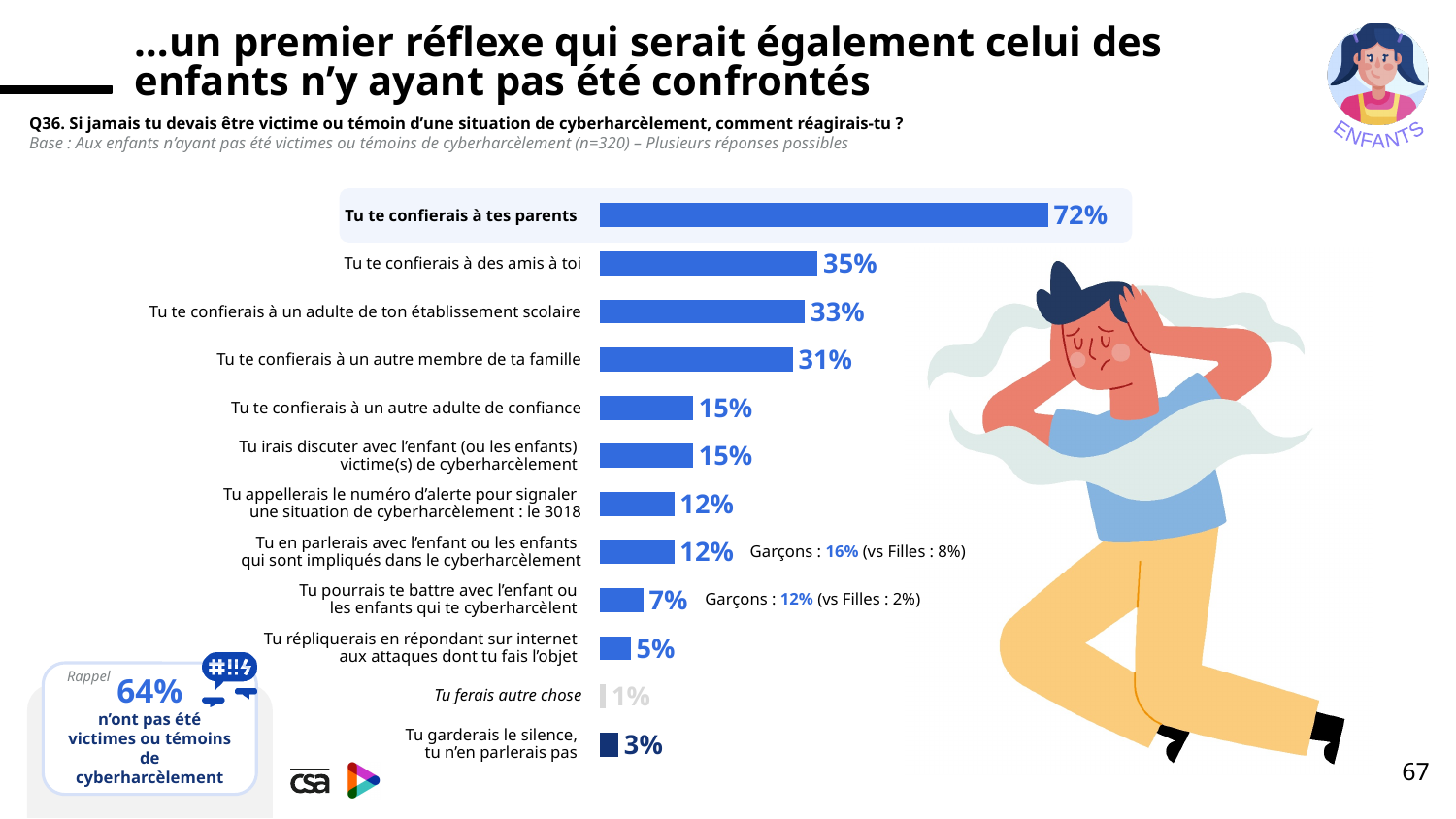
What is the difference in percentage points between "Tu te confierais à tes parents" and "Tu te confierais à des amis à toi"? 37 percentage points What percentage of children say they would confide in their parents ("Tu te confierais à tes parents")? 72% Which response has the lowest percentage? Tu ferais autre chose Which response has the highest percentage? Tu te confierais à tes parents What is the value for "Tu garderais le silence, tu n'en parlerais pas"? 3% How many response categories are plotted in the chart? 12 According to the annotation next to "Tu pourrais te battre avec l'enfant ou les enfants qui te cyberharcèlent", what is the value for boys (Garçons)? 12% What kind of chart is shown on the slide? Bar chart Which is larger: the value for "Tu te confierais à un adulte de ton établissement scolaire" or for "Tu te confierais à un autre membre de ta famille"? Tu te confierais à un adulte de ton établissement scolaire According to the annotation next to "Tu en parlerais avec l'enfant ou les enfants qui sont impliqués dans le cyberharcèlement", what is the value for girls (Filles)? 8% What is the value for "Tu te confierais à des amis à toi"? 35% What is the value for "Tu appellerais le numéro d'alerte pour signaler une situation de cyberharcèlement : le 3018"? 12%